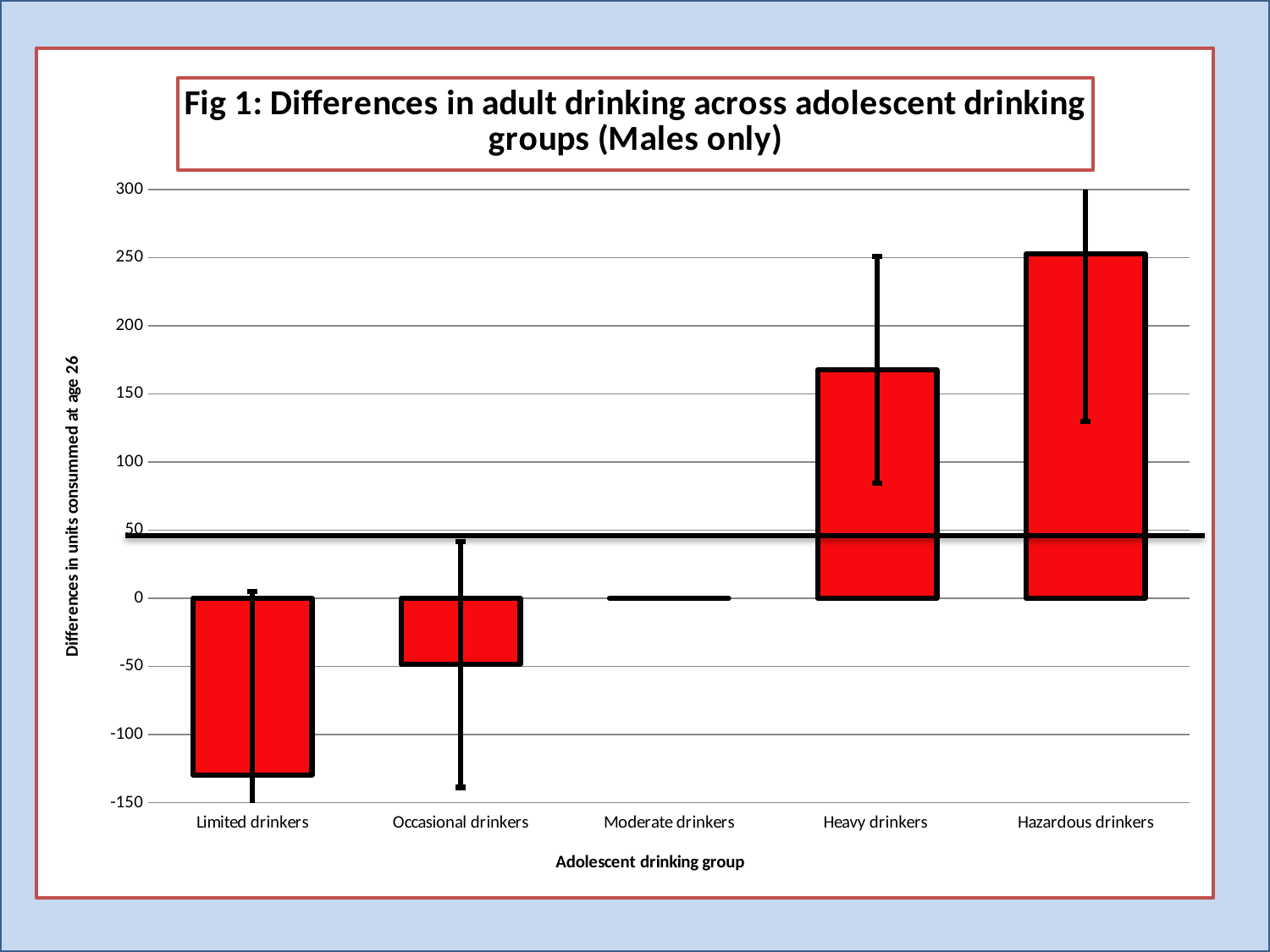
What is the label on the y axis? Differences in units consummed at age 26 Which adolescent drinking group has the lowest value? Limited drinkers Is the value for Heavy drinkers greater or less than 150? greater What is the value for Moderate drinkers? 0 What is the title of the chart? Fig 1: Differences in adult drinking across adolescent drinking groups (Males only) How many adolescent drinking groups are plotted on the x axis? 5 Which adolescent drinking group has the highest value? Hazardous drinkers Do the values rise or fall moving from Limited drinkers to Hazardous drinkers along the x axis? Rise Is the value for Limited drinkers greater or less than -100? less What kind of chart is shown on the slide? Bar chart Which is larger, the value for Heavy drinkers or the value for Hazardous drinkers? Hazardous drinkers Is the value for Hazardous drinkers greater or less than 200? greater